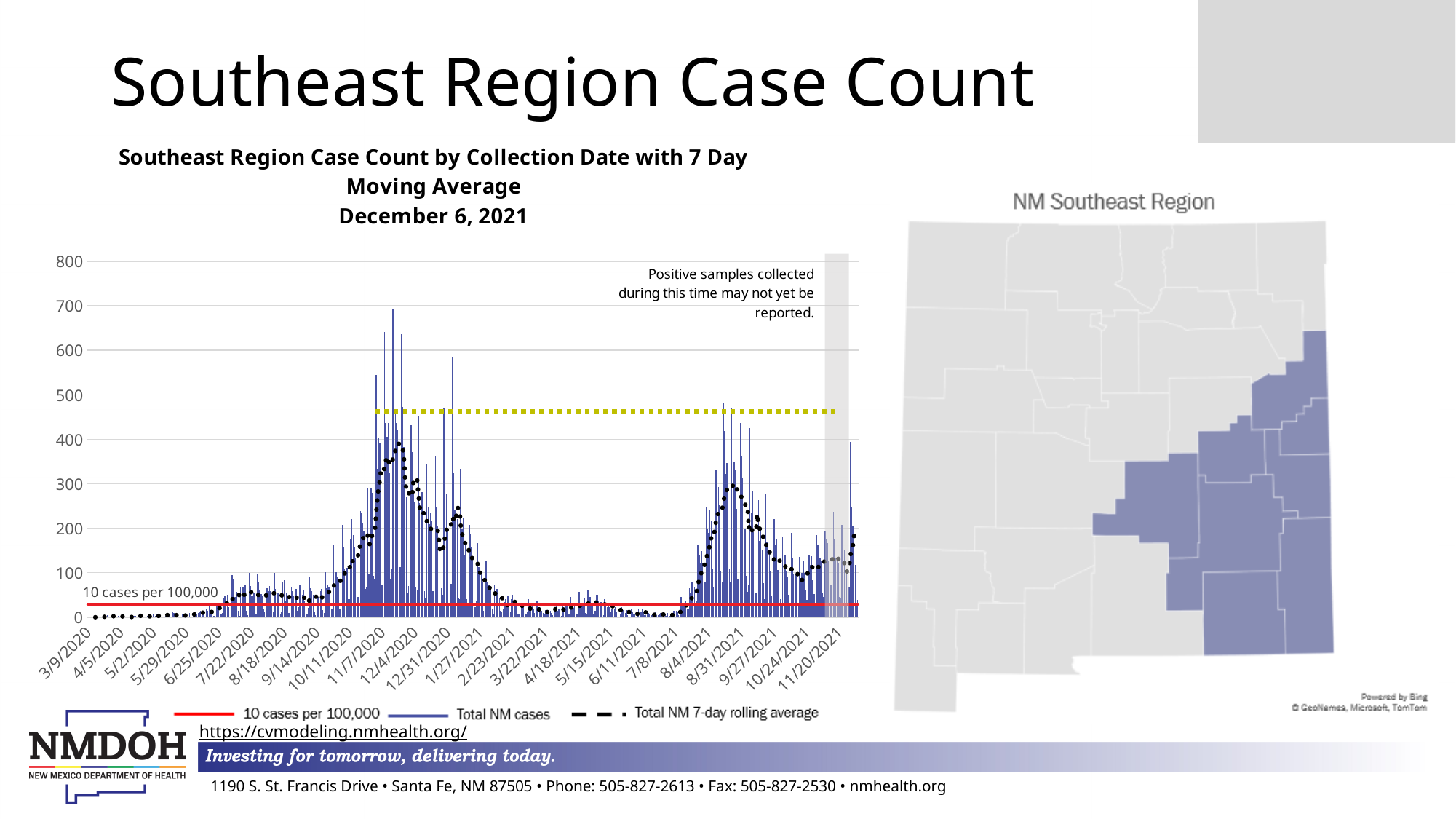
Is the peak of the 7-day rolling average around 8/31/2021 greater or less than 200? greater Does the 7-day rolling average rise or fall between 12/4/2020 and 3/22/2021? fall Is the red '10 cases per 100,000' line greater or less than 100 on the y axis? less What is the highest value shown on the y axis of the case count chart? 800 What is the first date label on the x axis of the case count chart? 3/9/2020 Are the daily case bars around 4/18/2021 greater or less than 100? less Does the 7-day rolling average rise or fall between 7/8/2021 and 8/31/2021? rise What kind of chart is used to show the Southeast Region case counts? bar chart How many series does the legend of the case count chart list? 3 Which wave had the higher peak in daily cases: the one around 11/7/2020–12/4/2020 or the one around 8/31/2021? 11/7/2020–12/4/2020